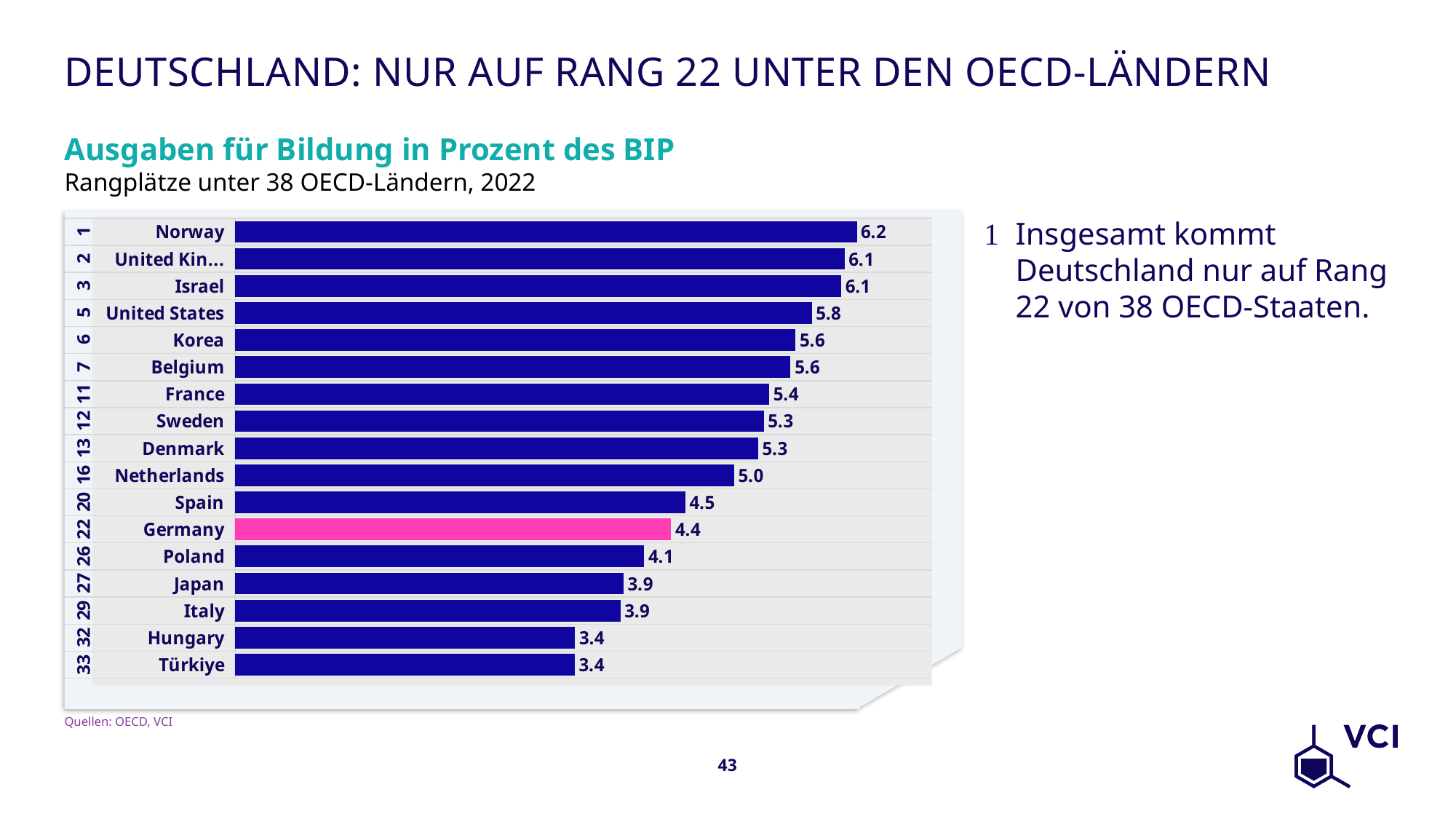
What is the value for Netherlands? 5.0 What is the difference between the values for Norway and Germany? 1.8 What is the value for Poland? 4.1 What is the value for Germany? 4.4 What kind of chart is shown on the slide? Bar chart What is the value for Norway? 6.2 How many countries are shown in the chart? 17 What is the difference between the values for Spain and Germany? 0.1 Which country has the highest value? Norway Which country's bar is highlighted in pink? Germany Which has the larger value, United States or Korea? United States Which has the larger value, Japan or Hungary? Japan